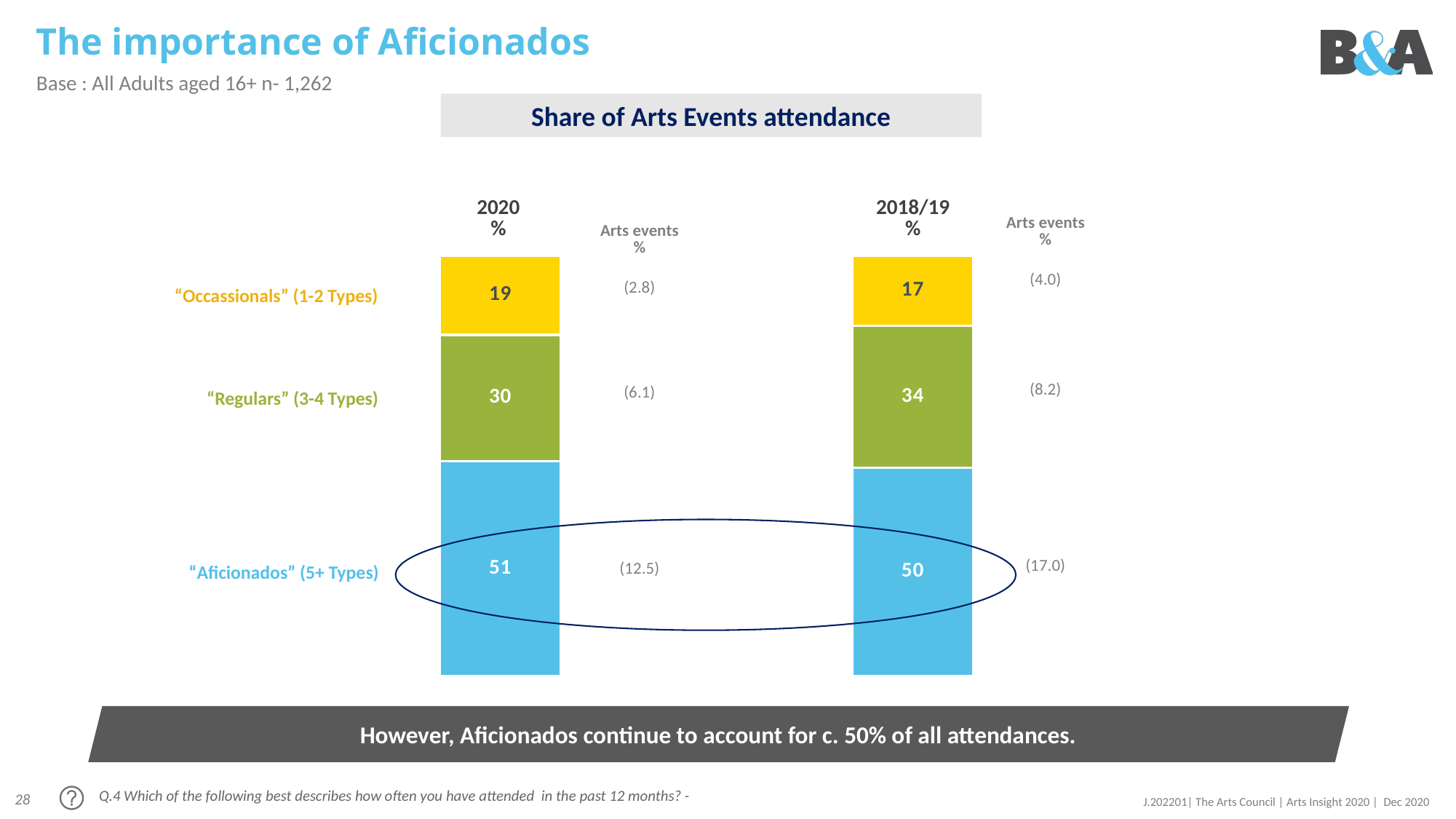
What is the value for "Regulars" (3-4 Types) in the 2018/19 bar? 34 What is the value for "Aficionados" (5+ Types) in the 2020 bar? 51 What kind of chart is shown on the slide? Stacked bar chart What is the title of the chart? Share of Arts Events attendance Which segment is the largest in the 2020 bar? "Aficionados" (5+ Types) What is the total of the 2020 stacked bar? 100 What is the Arts events % figure shown next to "Aficionados" (5+ Types) for 2018/19? (17.0) Which segment is the smallest in the 2018/19 bar? "Occassionals" (1-2 Types) What is the difference between the "Regulars" (3-4 Types) values for 2018/19 and 2020? 4 How many segments does each stacked bar contain? 3 What is the value for "Occassionals" (1-2 Types) in the 2020 bar? 19 Which is larger: the "Occassionals" (1-2 Types) value for 2020 or for 2018/19? 2020